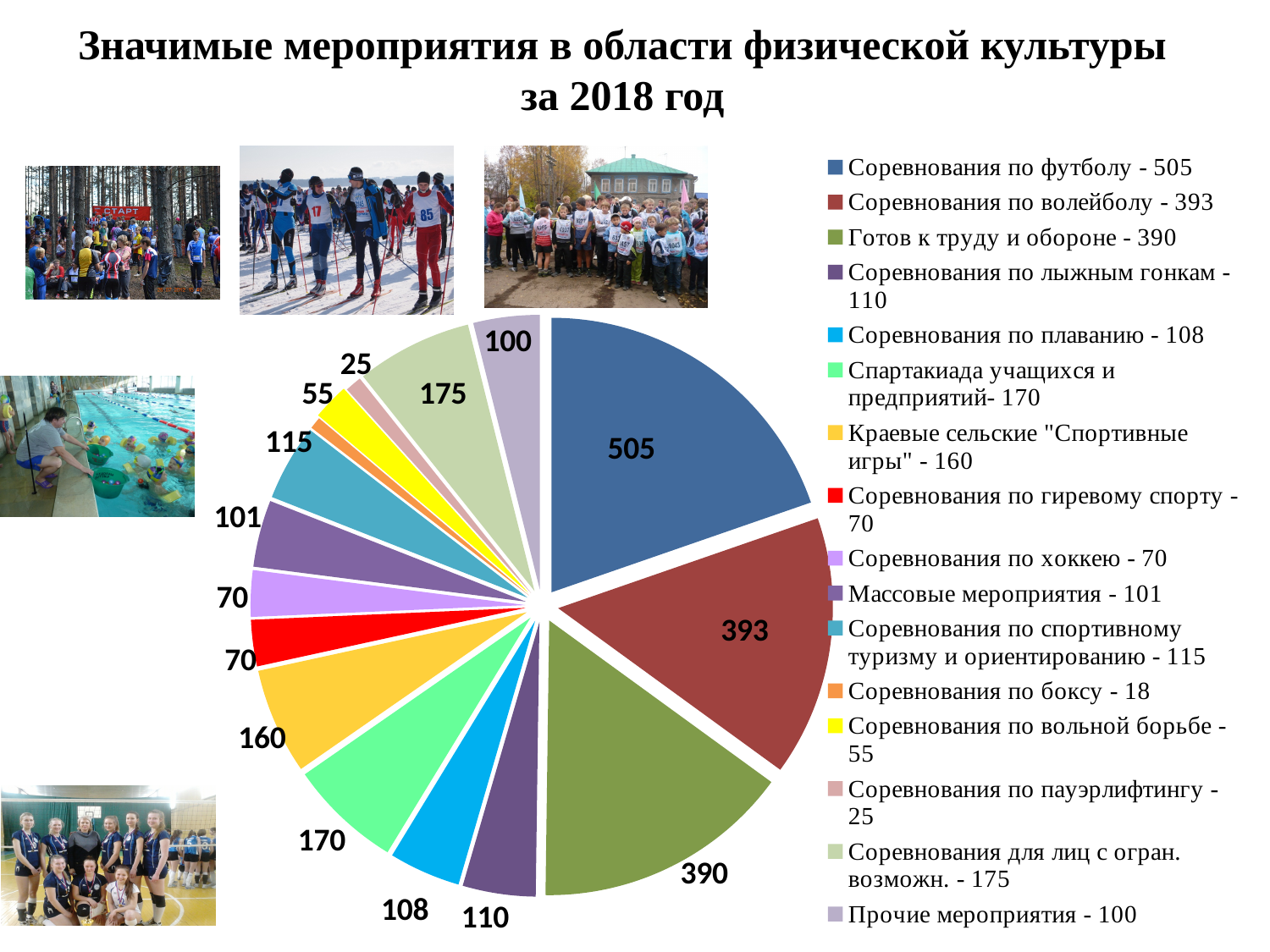
What is the difference between the values for Соревнования по футболу and Соревнования по волейболу? 112 What kind of chart is shown on the slide? pie chart What is the value for Прочие мероприятия? 100 Which is larger: the value for Спартакиада учащихся и предприятий or the value for Соревнования для лиц с огран. возможн.? Соревнования для лиц с огран. возможн. Which category has the smallest value in the pie chart? Соревнования по боксу Which category has the largest value in the pie chart? Соревнования по футболу What is the value for Соревнования по волейболу? 393 What is the value for Соревнования по спортивному туризму и ориентированию? 115 How many categories does the pie chart have? 16 What is the title of the slide containing the pie chart? Значимые мероприятия в области физической культуры за 2018 год What is the value for Соревнования по пауэрлифтингу? 25 What is the value for Готов к труду и обороне? 390